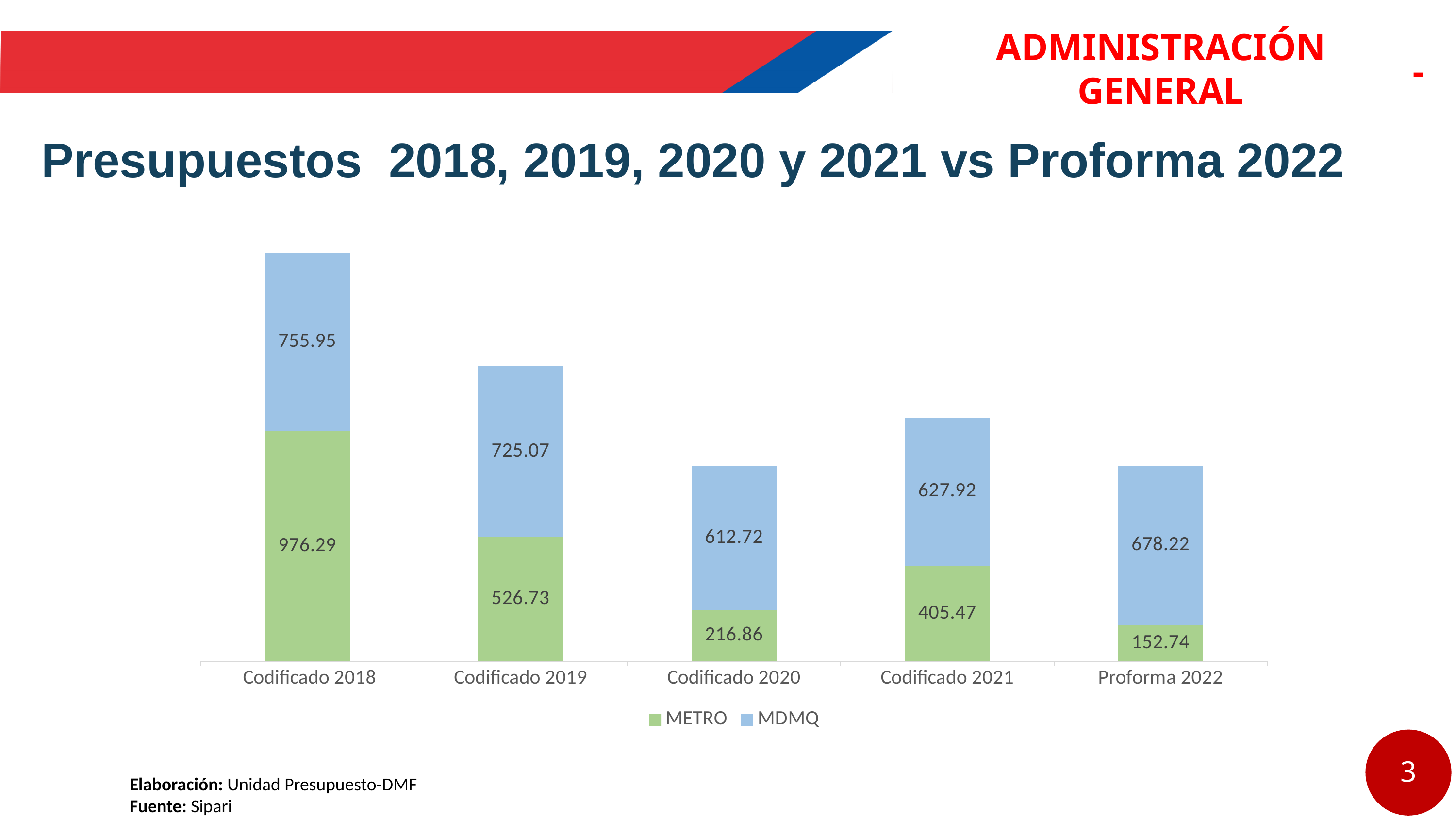
What kind of chart is shown on the slide? Stacked bar chart Which is larger, the METRO value for Codificado 2021 or the METRO value for Codificado 2020? Codificado 2021 What is the METRO value for Codificado 2018? 976.29 Which category has the lowest MDMQ value? Codificado 2020 What is the total of the stacked bar for Codificado 2021? 1033.39 What is the METRO value for Codificado 2020? 216.86 How many series does the legend list? 2 How many categories are shown on the x axis? 5 Which category has the lowest METRO value? Proforma 2022 What is the MDMQ value for Proforma 2022? 678.22 What is the difference between the MDMQ values for Codificado 2018 and Codificado 2019? 30.88 Which category has the highest METRO value? Codificado 2018